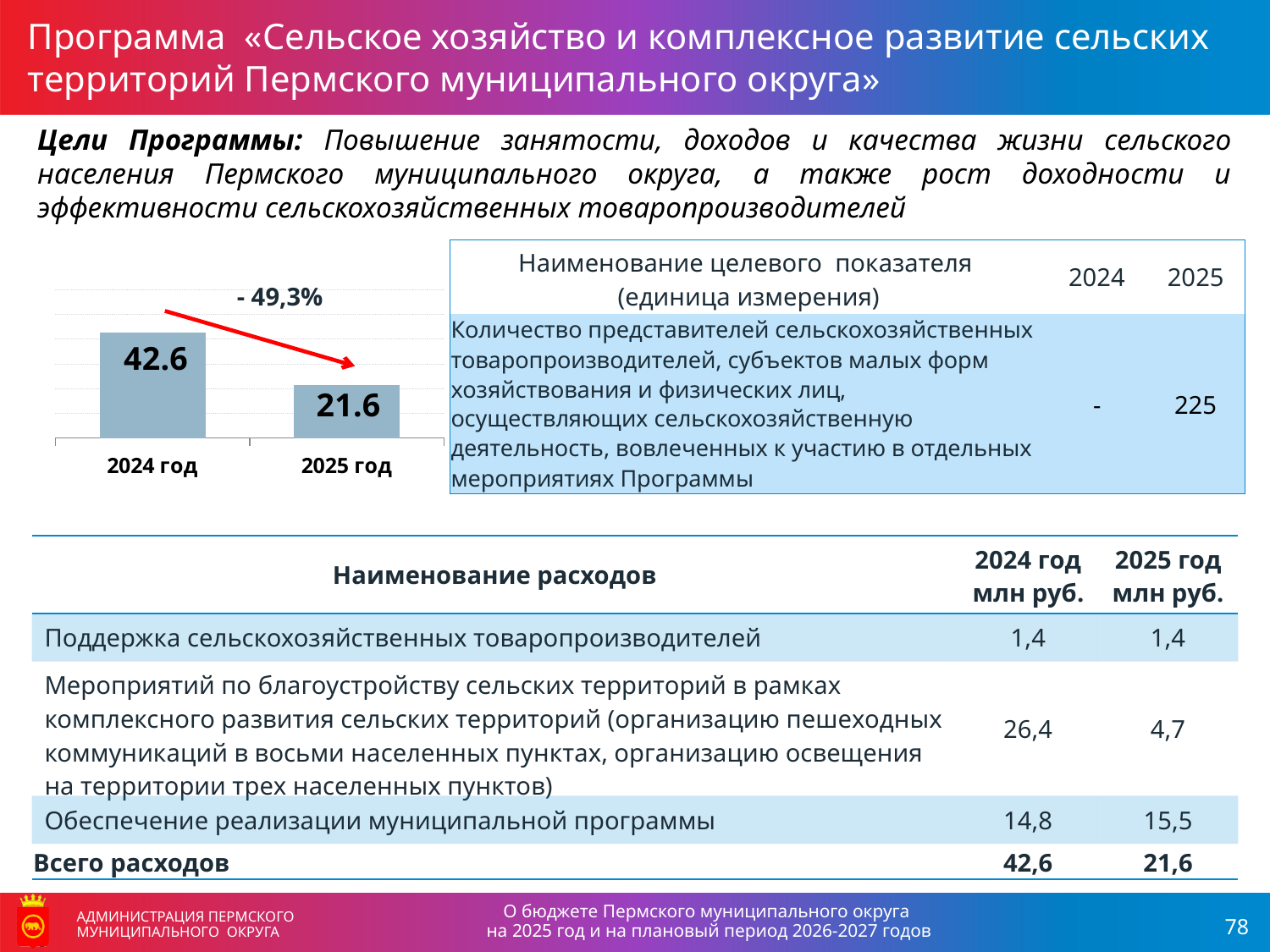
What is the value shown for 2025 год in the bar chart? 21.6 Do the values in the chart rise or fall from 2024 год to 2025 год? fall Which year has the lower bar in the chart? 2025 год Which year has the higher bar in the chart? 2024 год How many bars are plotted in the chart? 2 Is the value for 2024 год larger or smaller than the value for 2025 год in the bar chart? larger What is the difference between the 2024 год and 2025 год values in the bar chart? 21.0 What colour are the bars in the chart? grey-blue What type of chart is shown on the slide? bar chart What percentage change is annotated above the bars in the chart? - 49,3% What is the value shown for 2024 год in the bar chart? 42.6